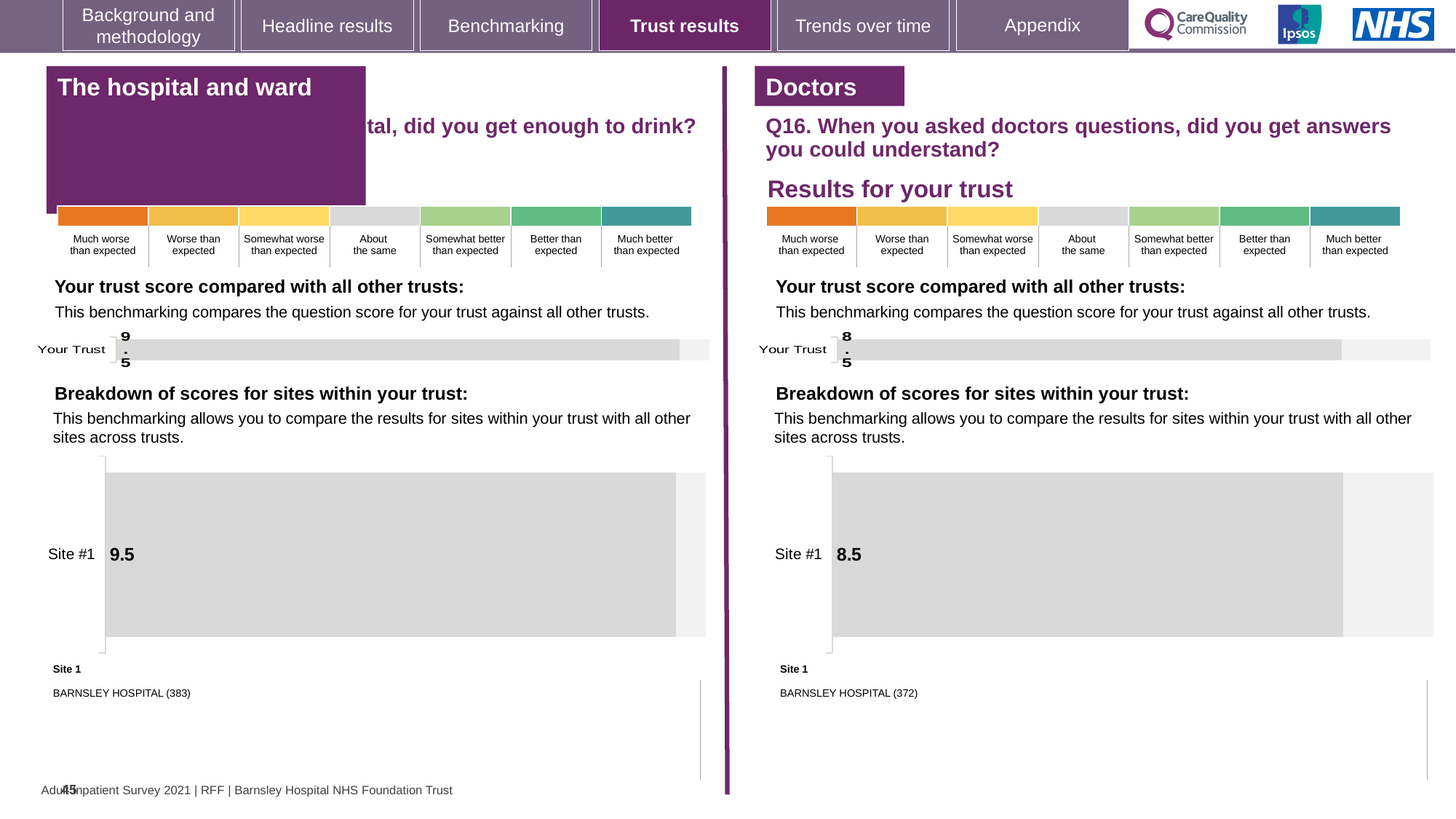
On the right-hand 'Your trust score compared with all other trusts' chart (Doctors, Q16), what is the score for Your Trust? 8.5 Which is larger: the Your Trust score on the left-hand chart (The hospital and ward) or the Your Trust score on the right-hand chart (Doctors, Q16)? The left-hand chart (The hospital and ward) How many rating categories does the colour key above the right-hand charts (Doctors, Q16) list? 7 On the right-hand 'Breakdown of scores for sites within your trust' chart (Q16), what is the score for Site #1? 8.5 On the left-hand 'Breakdown of scores for sites within your trust' chart, what is the score for Site #1? 9.5 How many sites are shown on the left-hand 'Breakdown of scores for sites within your trust' chart? 1 On the left-hand 'Your trust score compared with all other trusts' chart (The hospital and ward section), what is the score for Your Trust? 9.5 Which hospital is listed as Site 1 beneath the right-hand breakdown chart (Q16)? BARNSLEY HOSPITAL (372) How many sites are shown on the right-hand 'Breakdown of scores for sites within your trust' chart (Q16)? 1 What is the difference between the Site #1 score on the left-hand breakdown chart and the Site #1 score on the right-hand breakdown chart? 1.0 What kind of chart is used for the site breakdown on the left-hand side (The hospital and ward)? Bar chart What kind of chart is used for the 'Your Trust' score on the right-hand side (Doctors, Q16)? Bar chart